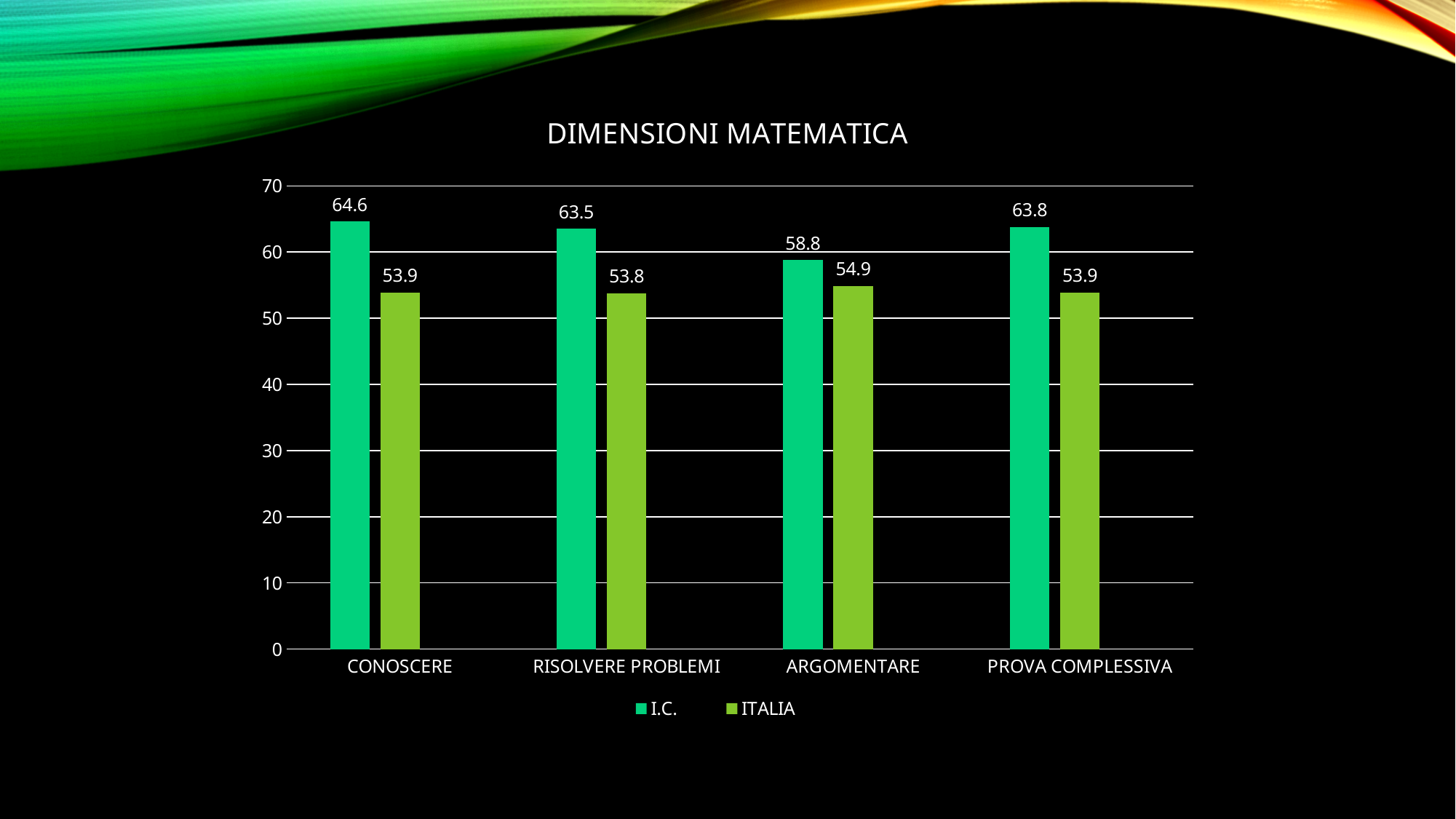
Which category has the highest I.C. value? CONOSCERE What is the I.C. value for CONOSCERE? 64.6 How many series does the legend list? 2 What is the difference between the I.C. and ITALIA values for ARGOMENTARE? 3.9 What is the difference between the I.C. and ITALIA values for CONOSCERE? 10.7 What is the I.C. value for PROVA COMPLESSIVA? 63.8 Which is larger for RISOLVERE PROBLEMI, the I.C. value or the ITALIA value? I.C. Which category has the lowest I.C. value? ARGOMENTARE How many categories are shown on the x axis? 4 What is the title of the chart? DIMENSIONI MATEMATICA Is the ITALIA value for PROVA COMPLESSIVA greater or less than 60? less What is the ITALIA value for ARGOMENTARE? 54.9